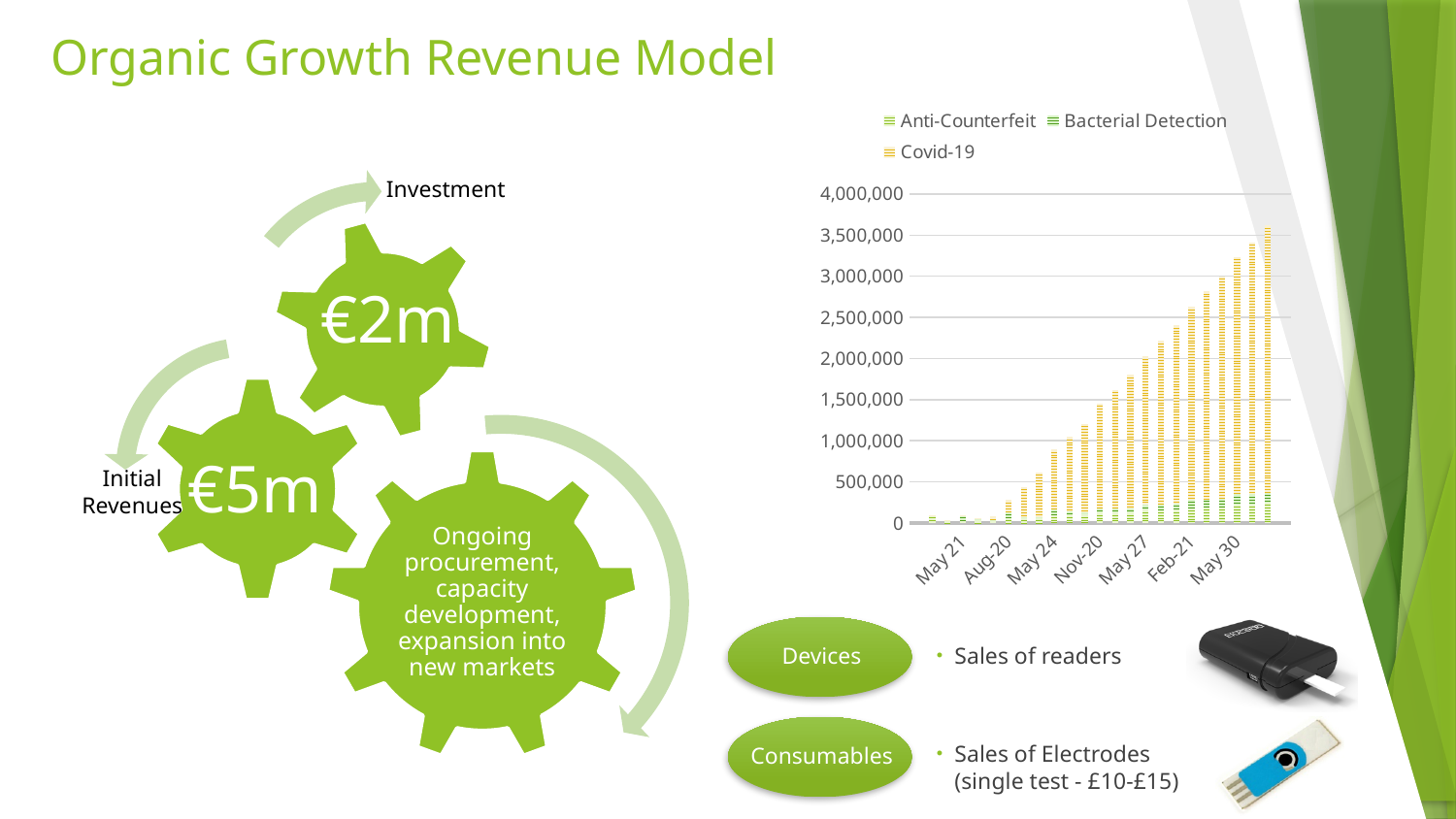
What kind of chart is shown on the right of the slide? Stacked bar chart Do the stacked bar totals rise or fall from left to right along the x axis? Rise Is the total for the bar at Nov-20 greater or less than 500,000? greater Which labelled x-axis point has the shortest stacked bar? May 21 What is the highest value shown on the chart's y axis? 4,000,000 Which has the larger stacked bar total, May 21 or May 30? May 30 Is the total for the bar at Feb-21 greater or less than 2,000,000? greater Which labelled x-axis point has the tallest stacked bar? May 30 How many series does the chart's legend list? 3 Which series are listed in the chart's legend? Anti-Counterfeit, Bacterial Detection, Covid-19 Is the total for the bar at May 21 greater or less than 500,000? less